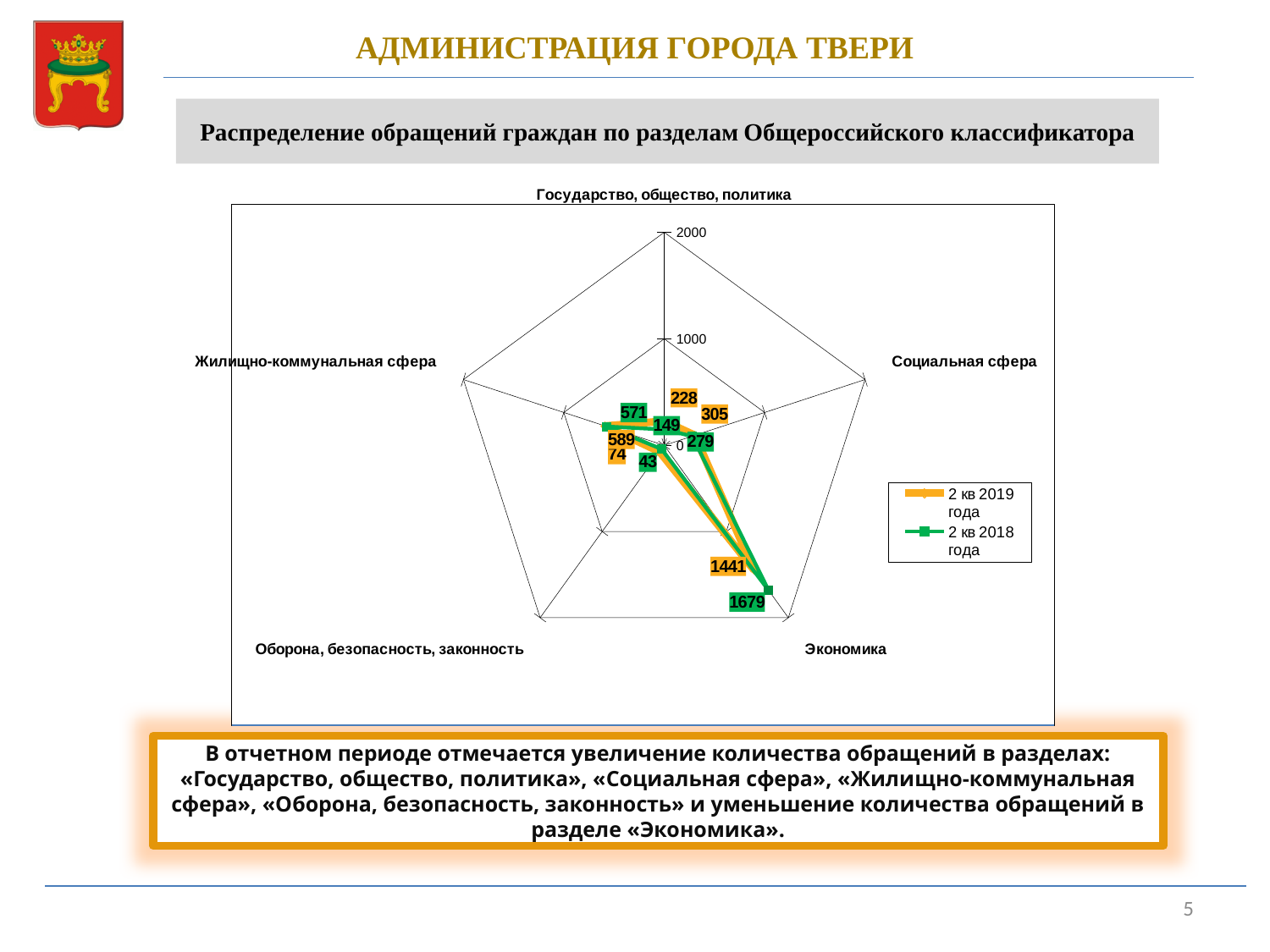
What is the value for «Оборона, безопасность, законность» in the series «2 кв 2018 года»? 43 Which category has the lowest value in the series «2 кв 2019 года»? Оборона, безопасность, законность Which colour represents the series «2 кв 2019 года»? Orange For «Государство, общество, политика», which series has the larger value: «2 кв 2019 года» or «2 кв 2018 года»? 2 кв 2019 года What is the value for «Экономика» in the series «2 кв 2019 года»? 1441 How many categories (axes) does the radar chart have? 5 What is the difference between the «Экономика» values for «2 кв 2018 года» and «2 кв 2019 года»? 238 What kind of chart is shown on the slide? Radar chart How many series does the legend list? 2 Which category has the highest value in the series «2 кв 2018 года»? Экономика What is the value for «Экономика» in the series «2 кв 2018 года»? 1679 What is the value for «Жилищно-коммунальная сфера» in the series «2 кв 2019 года»? 589